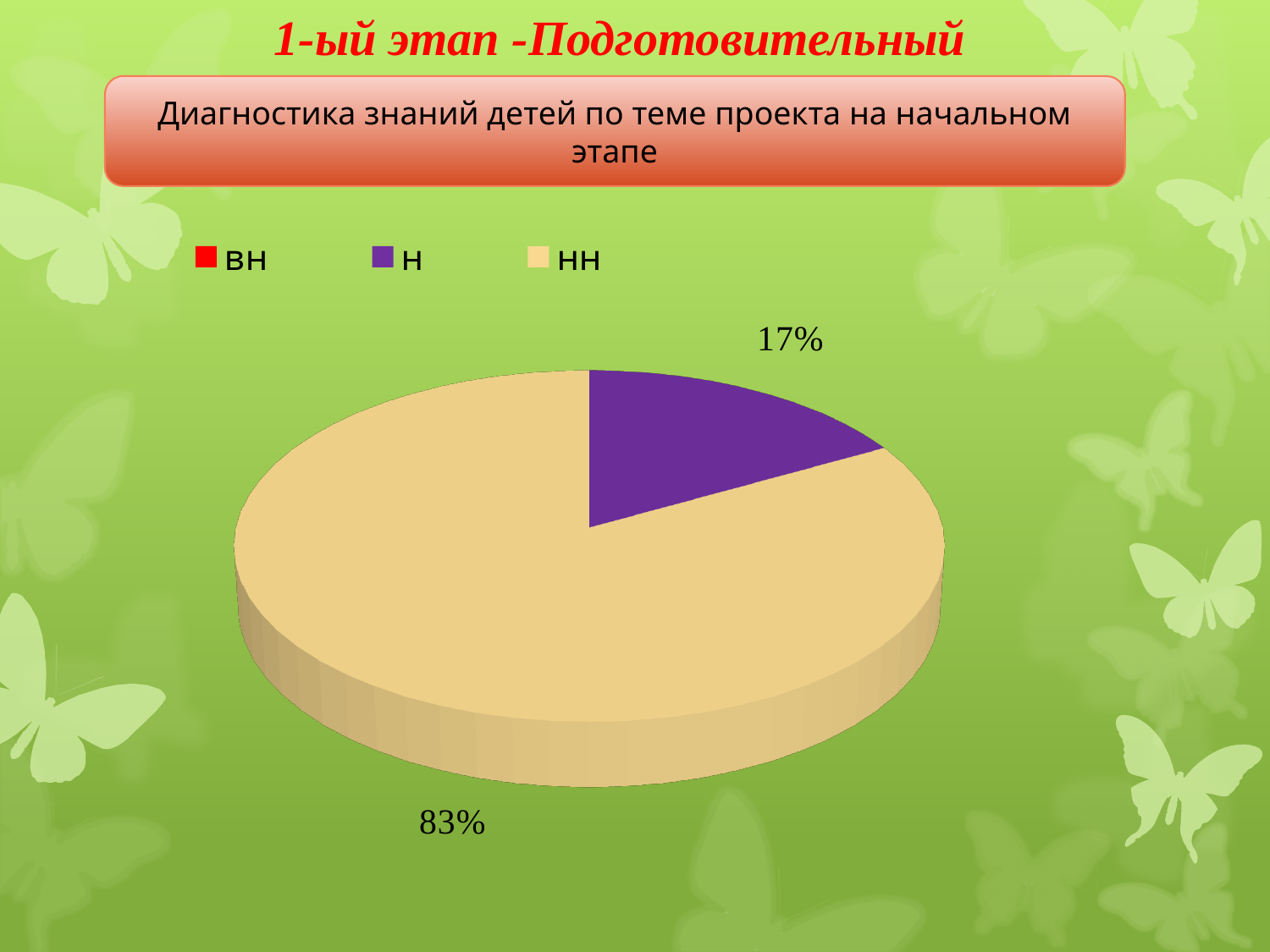
What percentage is shown for the НН slice of the pie chart? 83% What percentage is shown for the Н slice of the pie chart? 17% What type of chart is shown on the slide? pie chart Which legend entry is shown in purple? Н What share of the pie does the Н slice represent? 17% Which category has the largest slice in the pie chart? НН What is the difference in percentage points between the НН slice and the Н slice? 66 What colour is the НН slice in the pie chart? beige How many entries does the legend of the pie chart list? 3 How many slices in the pie chart have a percentage label? 2 Which of the two labelled slices, Н or НН, is larger? НН